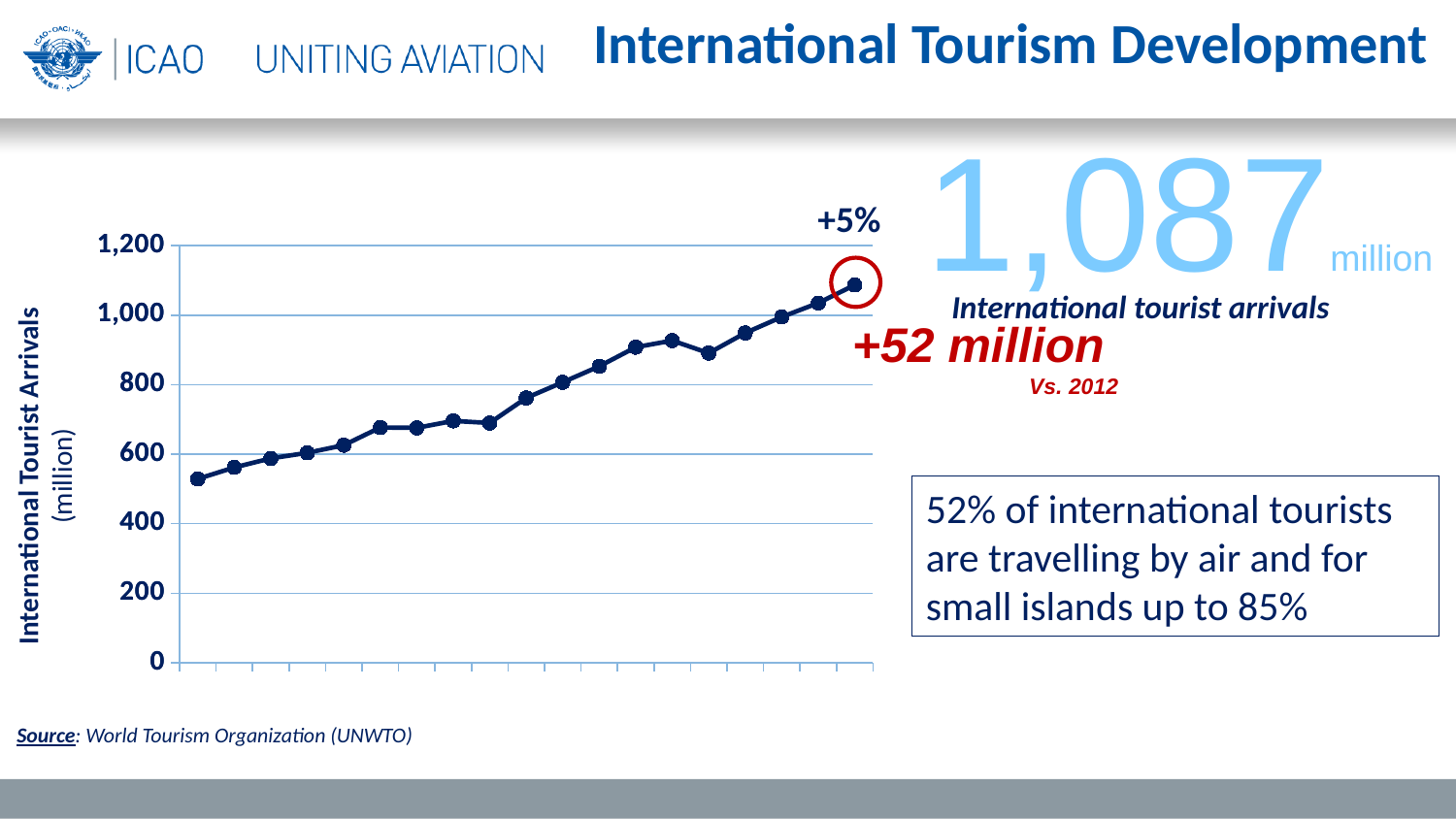
Do the values in the chart generally rise or fall from left to right? rise What kind of chart is shown on the slide? line chart What value, in million, does the circled final point on the line represent according to the slide? 1,087 million What is the label of the vertical axis of the chart? International Tourist Arrivals (million) How many data points are plotted on the line? 19 Which point on the line is higher, the leftmost point or the rightmost point? the rightmost point What is the highest tick value shown on the vertical axis? 1,200 Is the value of the first point on the line greater or less than 400? greater Is the lowest point on the line greater or less than 800? less Is the value of the first (leftmost) point on the line greater or less than 600? less What percentage change is annotated next to the circled final point of the line? +5%